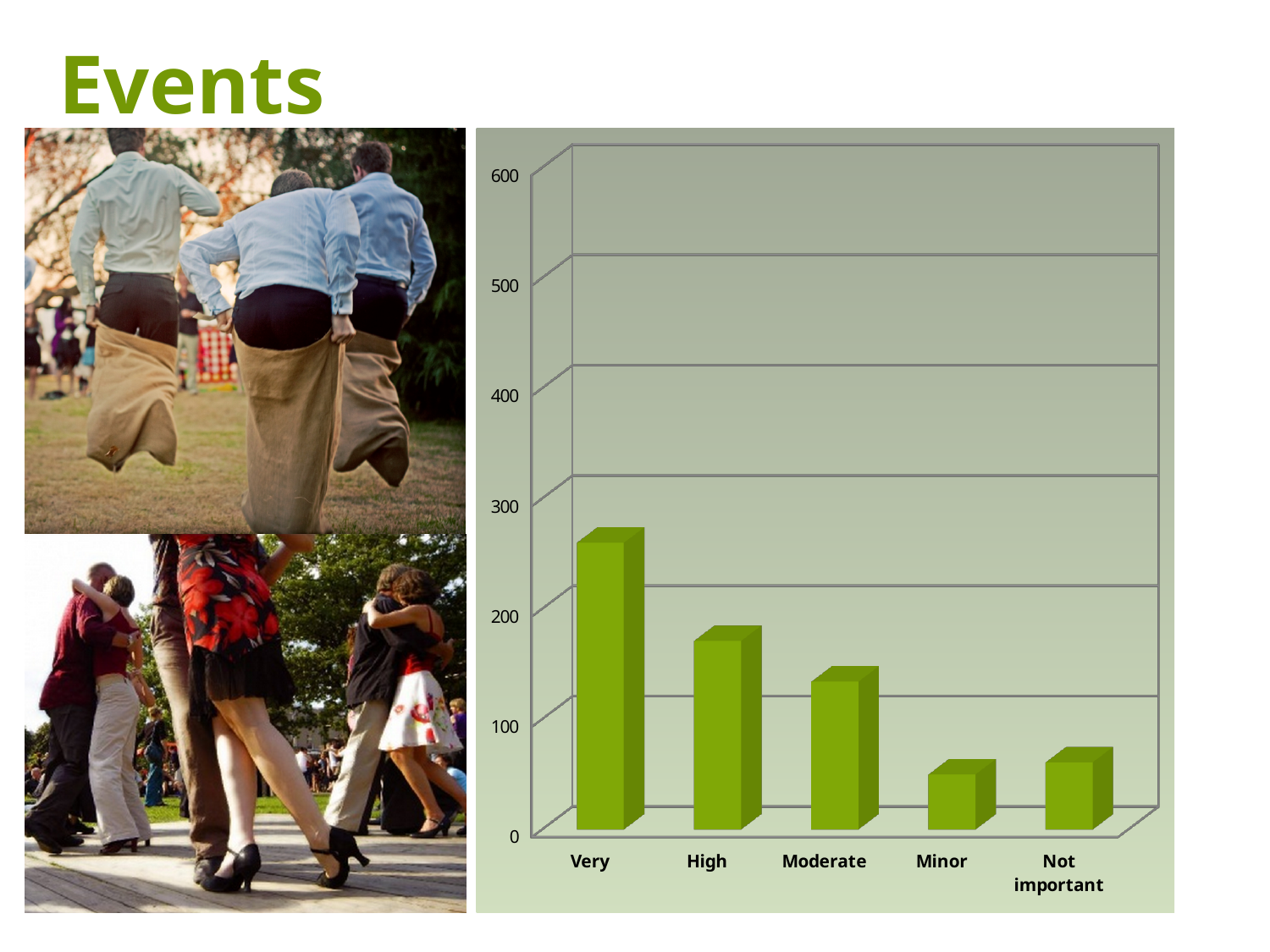
What colour are the bars in the chart? green What kind of chart is shown on the slide? bar chart Which category has the lowest bar in the chart? Minor Is the value for Very greater or less than 300? less Is the value for Very greater or less than 200? greater Is the value for High greater or less than 200? less Which is larger, the value for Very or the value for High? Very Which is larger, the value for High or the value for Moderate? High How many categories are shown on the x axis of the chart? 5 Which category has the highest bar in the chart? Very